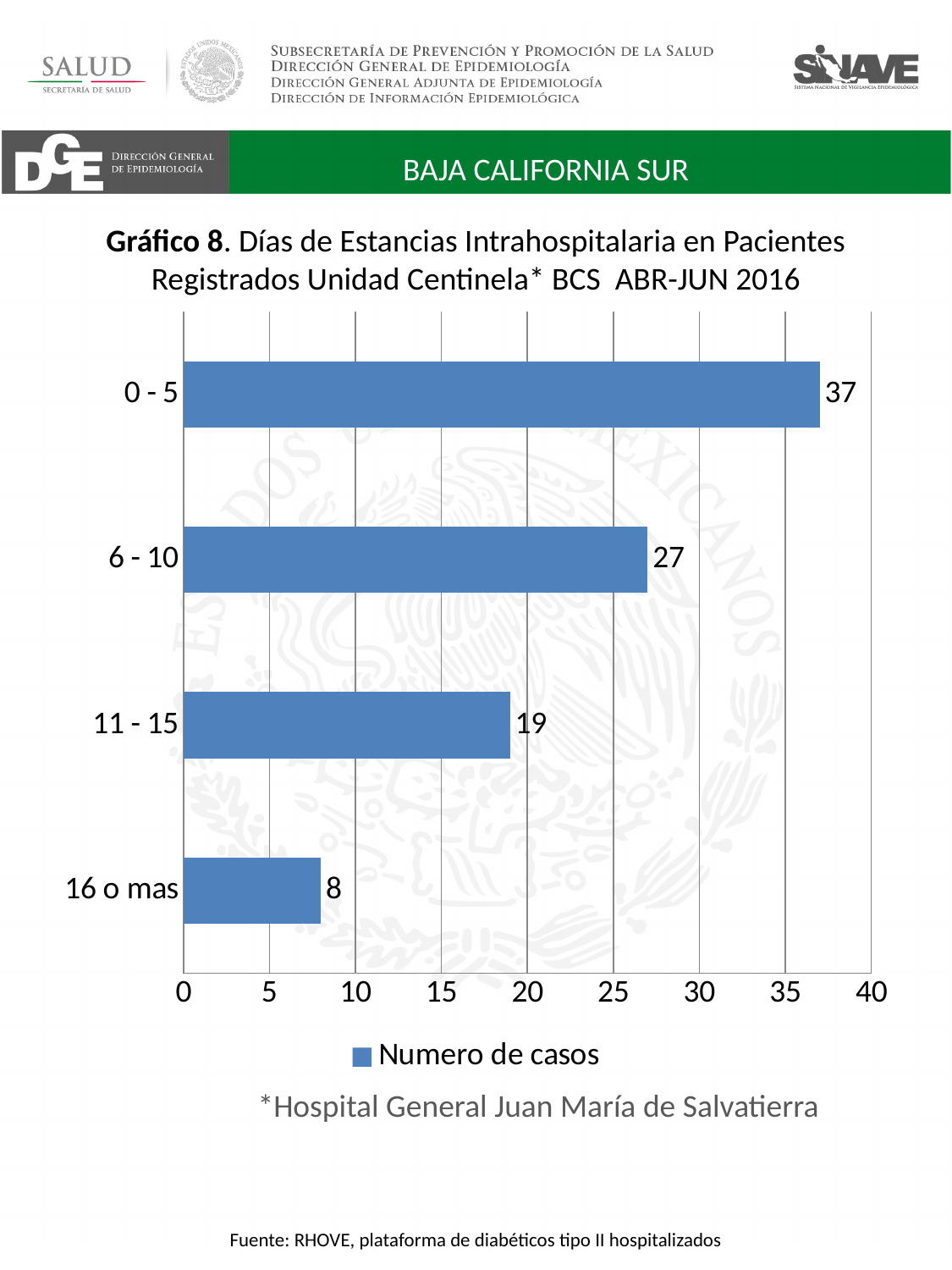
How many series does the legend list? 1 What is the number of cases for the 6 - 10 days category? 27 What is the number of cases for the 16 o mas category? 8 What is the difference in number of cases between the 0 - 5 and 6 - 10 categories? 10 How many categories are shown on the chart? 4 Which category has the lowest number of cases? 16 o mas What is the number of cases for the 11 - 15 days category? 19 What is the number of cases for the 0 - 5 days category? 37 Which has more cases, 11 - 15 or 16 o mas? 11 - 15 What is the legend entry for the series shown in the chart? Numero de casos Which category has the highest number of cases? 0 - 5 What kind of chart is shown on the slide? Bar chart